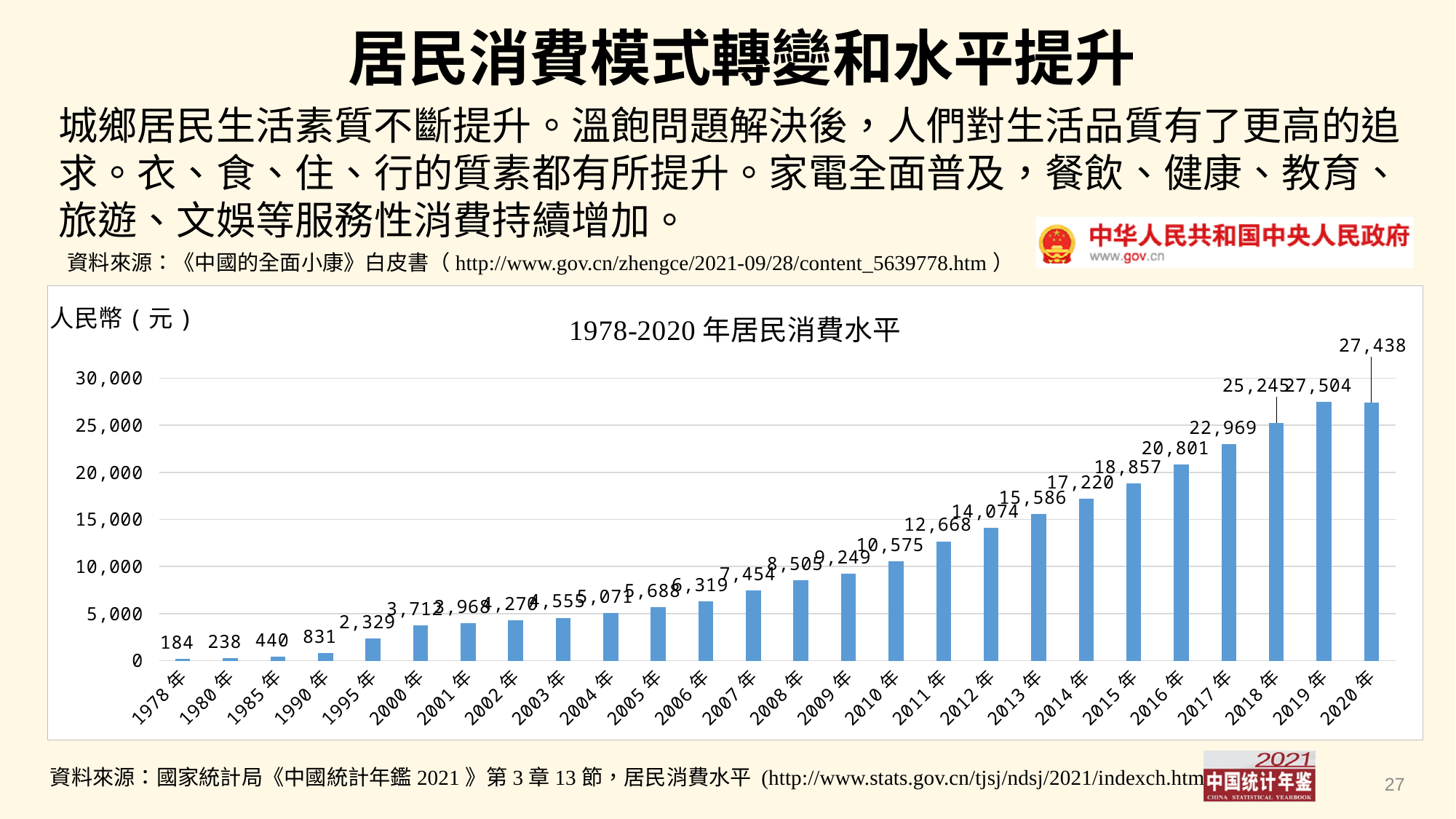
What is the value for 2020年? 27,438 Is the value for 2015年 greater or less than 15,000? greater What is the value for 1978年? 184 What is the value for 2010年? 10,575 Which year has the highest value in the chart? 2019年 What unit is shown for the vertical axis of the chart? 人民幣（元） What is the title of the chart? 1978-2020 年居民消費水平 What is the difference between the values for 2017年 and 2016年? 2,168 Which year has the lowest value in the chart? 1978年 Do the values generally rise or fall from 1978年 to 2019年? rise What type of chart is shown on the slide? bar chart How many years (bars) are plotted in the chart? 26